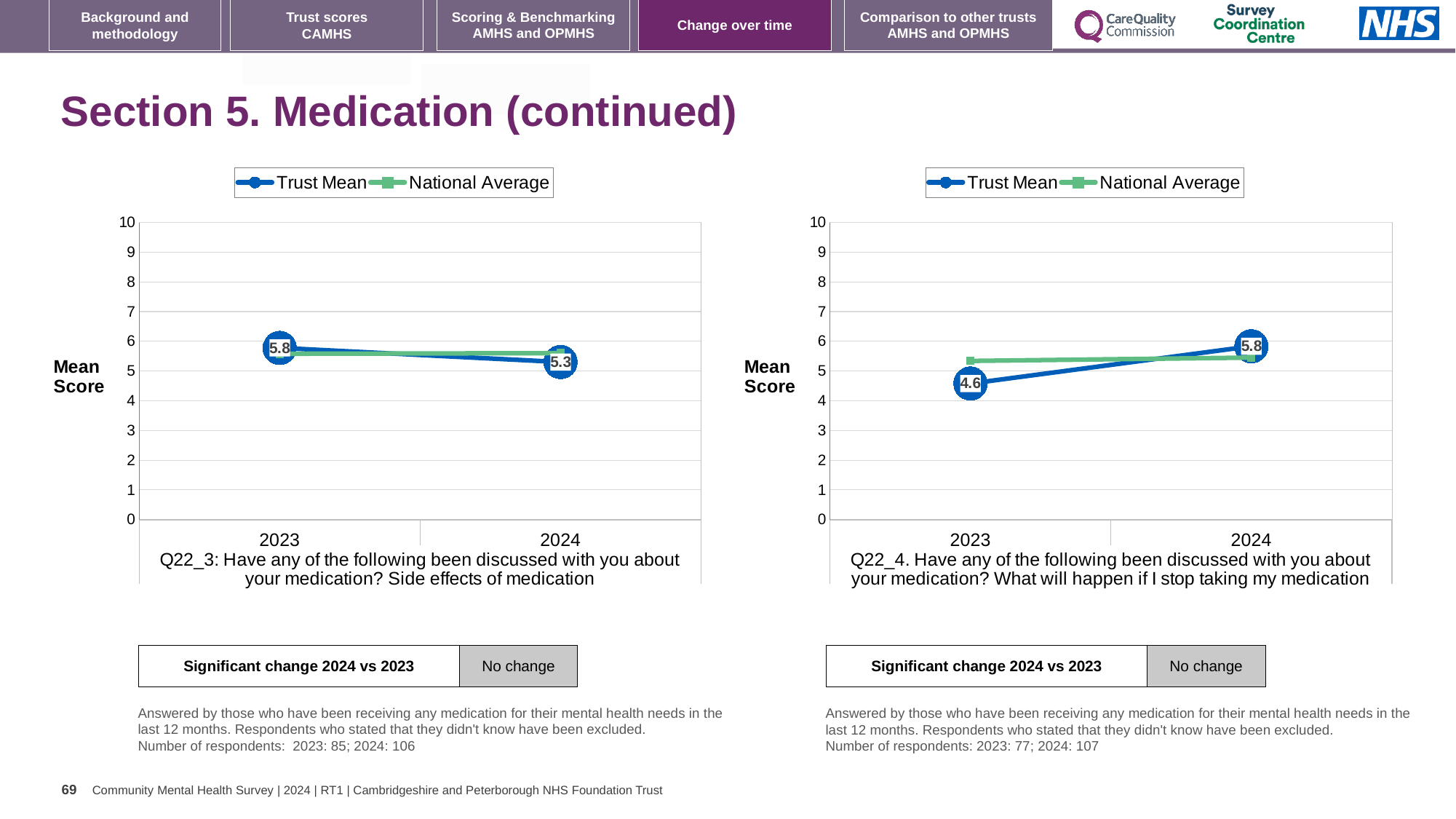
On the right chart (Q22_4), which is larger in 2023: the Trust Mean or the National Average? National Average On the right chart (Q22_4), what is the Trust Mean for 2023? 4.6 On the left chart (Q22_3), does the Trust Mean rise or fall from 2023 to 2024? fall How many series does the legend of the right chart (Q22_4) list? 2 On the left chart (Q22_3), by how much did the Trust Mean change from 2023 to 2024? 0.5 On the right chart (Q22_4), what is the difference between the Trust Mean in 2024 and in 2023? 1.2 On the right chart (Q22_4), is the National Average for 2023 greater or less than 5? greater What kind of chart is the left chart (Q22_3)? line chart On the right chart (Q22_4), does the Trust Mean rise or fall from 2023 to 2024? rise On the right chart (Q22_4), what is the Trust Mean for 2024? 5.8 On the left chart (Q22_3), what is the Trust Mean for 2024? 5.3 On the left chart (Q22_3), what is the Trust Mean for 2023? 5.8